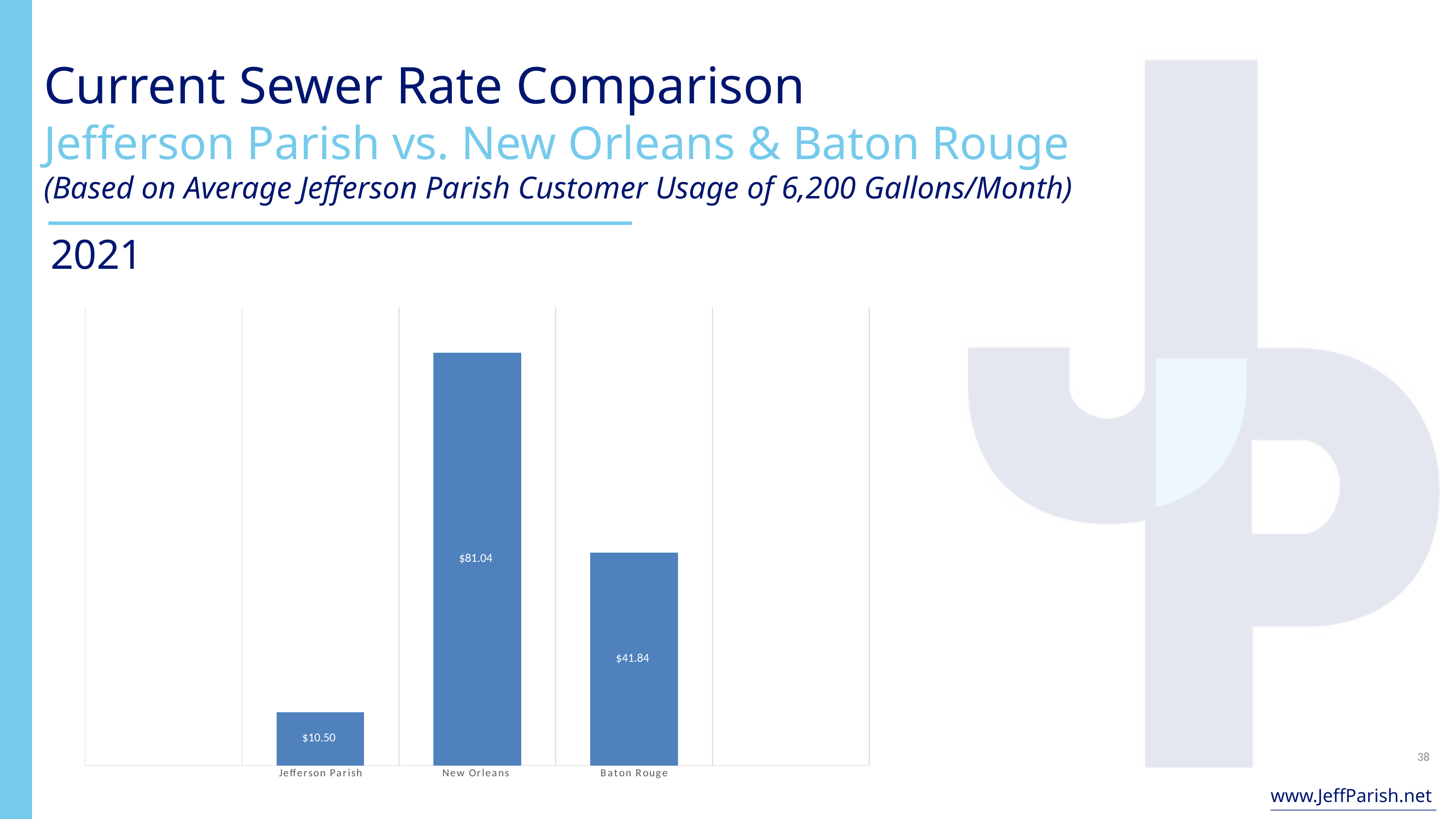
What year is the chart labelled with? 2021 What is the sewer rate shown for New Orleans? $81.04 How many cities or parishes are compared on the chart? 3 What is the sewer rate shown for Baton Rouge? $41.84 What is the difference between the Baton Rouge rate and the Jefferson Parish rate? $31.34 What is the difference between the New Orleans rate and the Jefferson Parish rate? $70.54 What is the difference between the New Orleans rate and the Baton Rouge rate? $39.20 Which city or parish has the highest sewer rate on the chart? New Orleans What kind of chart is shown on the slide? Bar chart Which city or parish has the lowest sewer rate on the chart? Jefferson Parish What is the sewer rate shown for Jefferson Parish? $10.50 Which has a higher sewer rate, Baton Rouge or Jefferson Parish? Baton Rouge